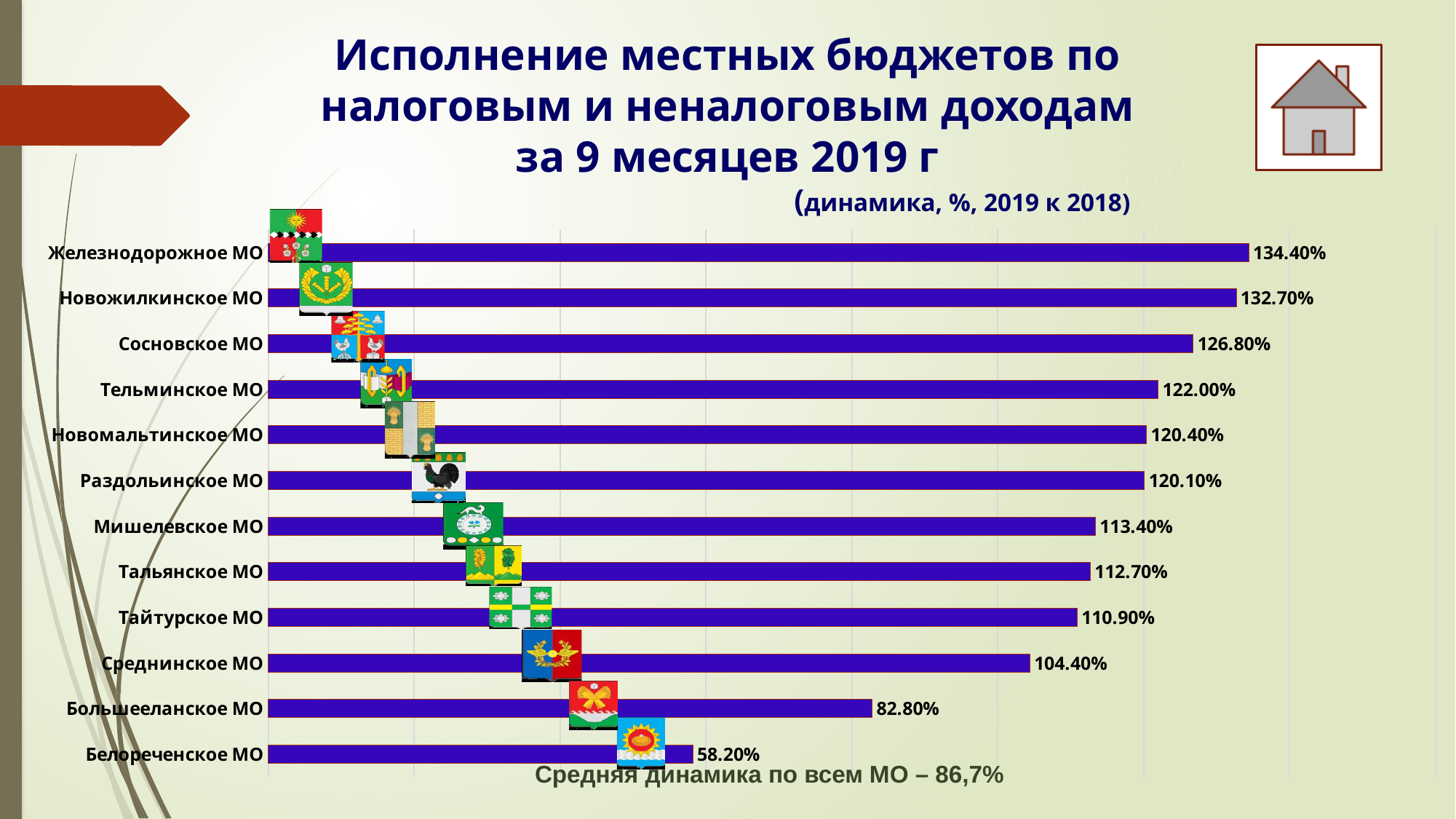
How many municipalities (МО) are shown in the chart? 12 Which has a larger value, Мишелевское МО or Среднинское МО? Мишелевское МО What type of chart is shown on the slide? Bar chart What is the value for Железнодорожное МО? 134.40% What is the value for Большееланское МО? 82.80% What is the difference between the values for Сосновское МО and Тельминское МО? 4.80 percentage points What is the value for Тельминское МО? 122.00% Which municipality has the highest value in the chart? Железнодорожное МО What average dynamics across all МО is stated below the chart? 86,7% What is the difference between the values for Железнодорожное МО and Белореченское МО? 76.20 percentage points Which municipality has the lowest value in the chart? Белореченское МО Do the values rise or fall going from the top bar to the bottom bar? Fall